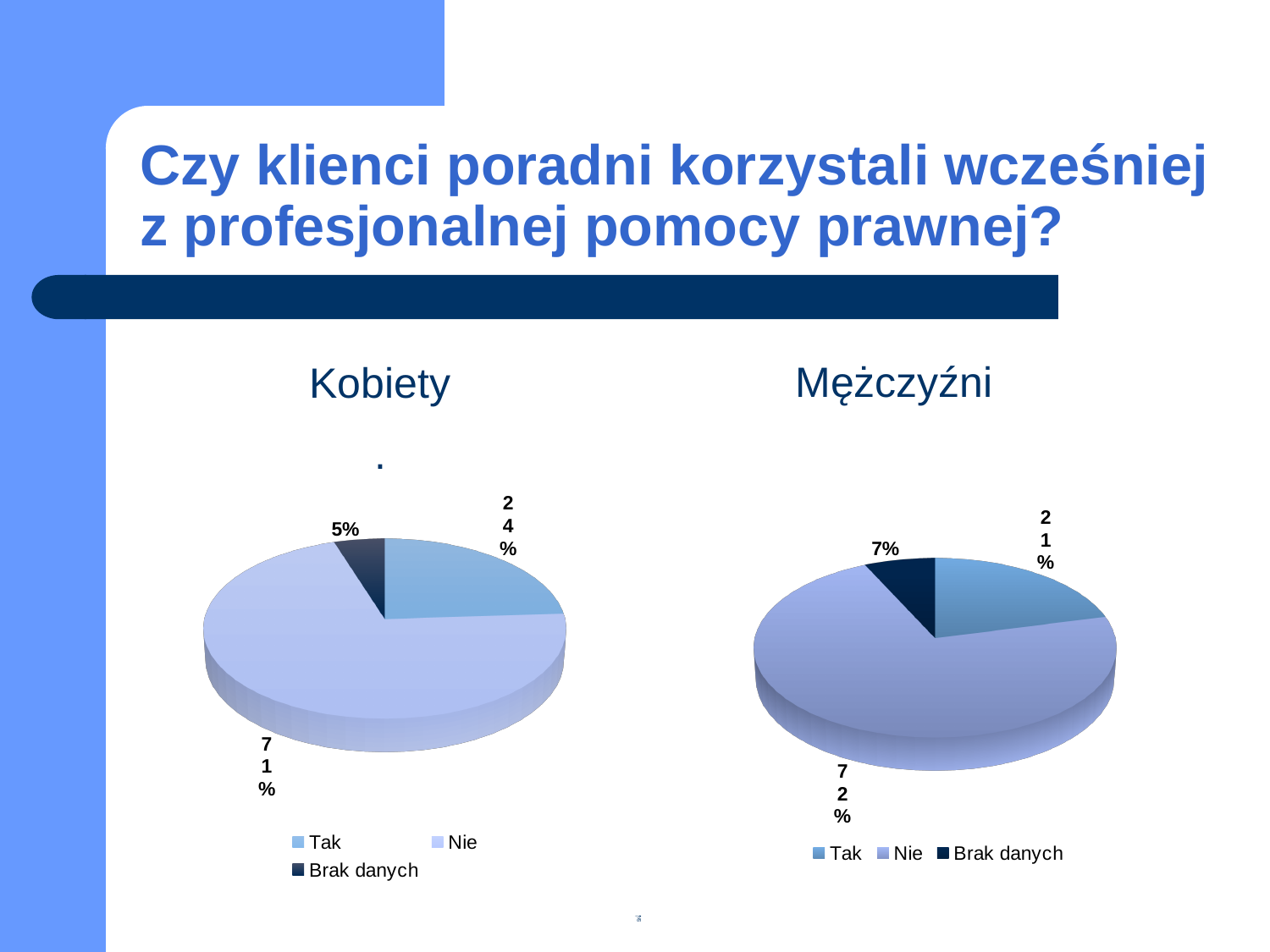
In the Kobiety chart, what percentage is shown for Nie? 71% In the Mężczyźni chart, which category has the smallest share? Brak danych In the Mężczyźni chart, what percentage is shown for Tak? 21% What type of chart is used for the Kobiety data? Pie chart In the Mężczyźni chart, what percentage is shown for Brak danych? 7% Which is larger: the Tak share in the Kobiety chart or the Tak share in the Mężczyźni chart? Kobiety In the Kobiety chart, which category has the largest share? Nie How many slices does the Mężczyźni pie chart have? 3 In the Kobiety chart, what is the difference between the Nie and Tak percentages? 47% How many entries does the legend of the Kobiety chart list? 3 In the Mężczyźni chart, what is the difference between the Nie and Brak danych percentages? 65% In the Kobiety chart, what percentage is shown for Tak? 24%